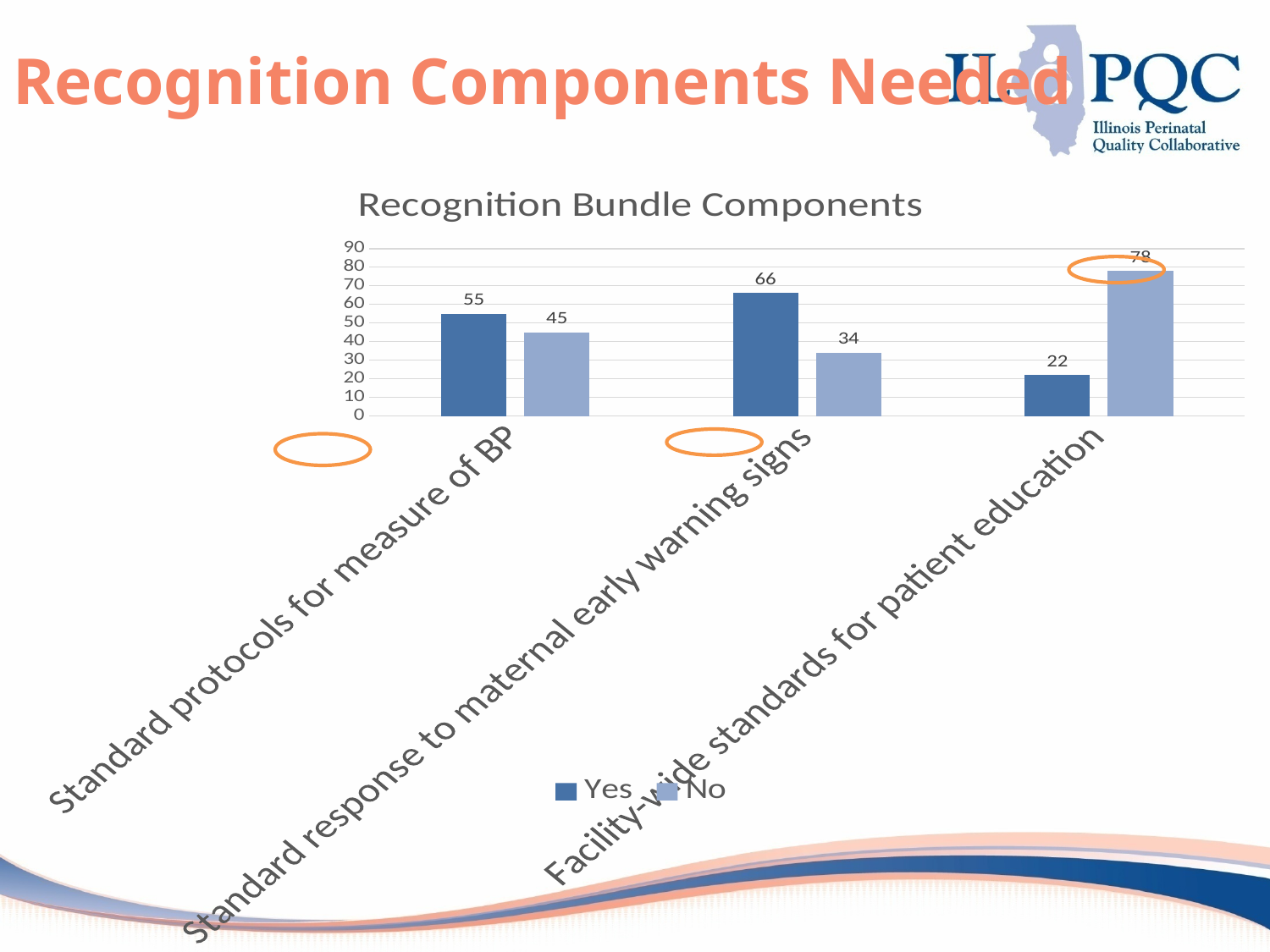
What is the title of the chart? Recognition Bundle Components What is the difference between the Yes and No values for Standard response to maternal early warning signs? 32 What is the No value for Standard response to maternal early warning signs? 34 What is the Yes value for Standard protocols for measure of BP? 55 For Standard protocols for measure of BP, which is larger, the Yes value or the No value? Yes Which category has the highest Yes value? Standard response to maternal early warning signs Is the No value for Facility-wide standards for patient education greater or less than 70? greater Which category has the lowest Yes value? Facility-wide standards for patient education How many series does the legend list? 2 How many categories are shown on the x axis? 3 What is the Yes value for Facility-wide standards for patient education? 22 What type of chart is shown on the slide? Bar chart